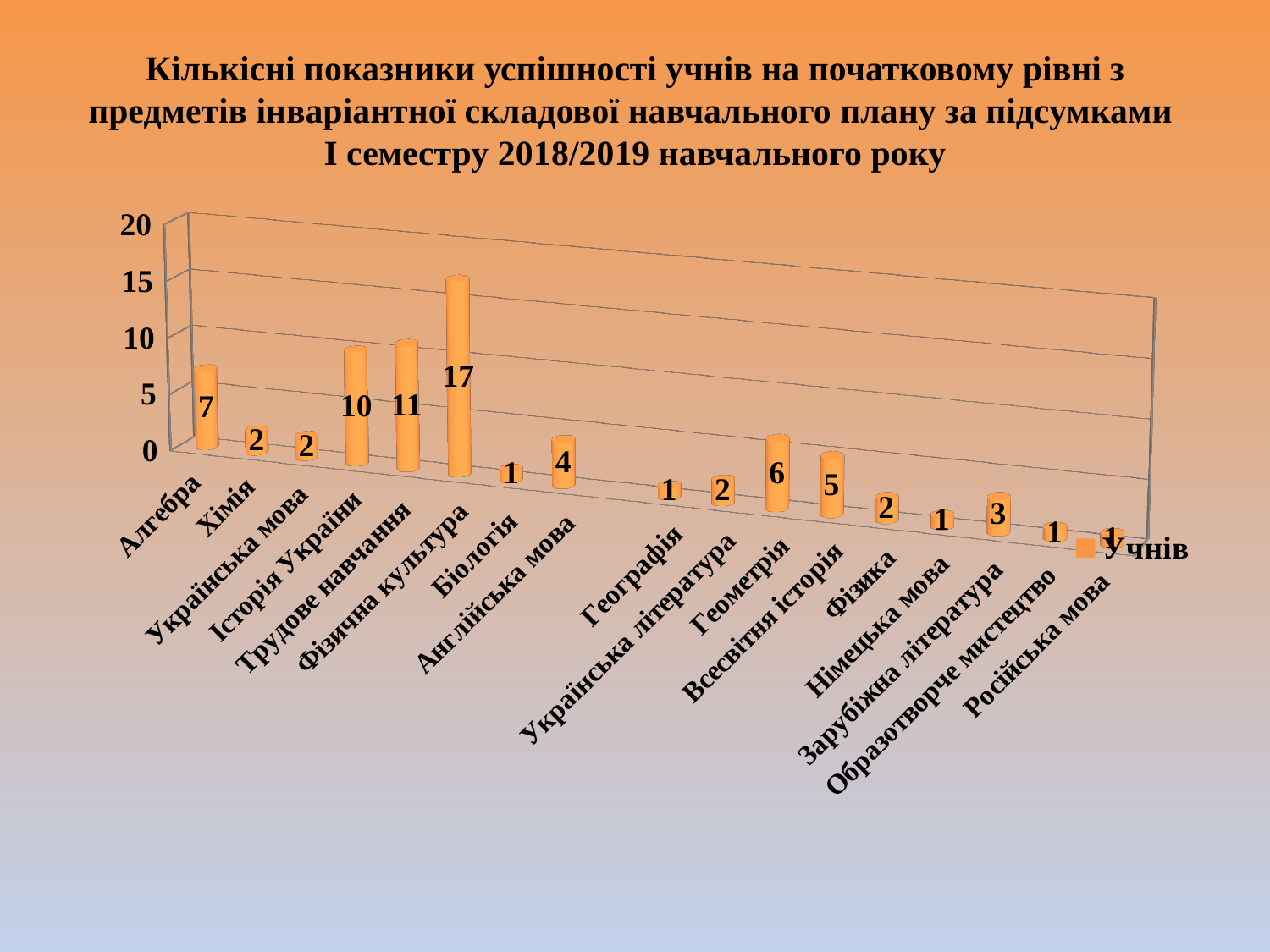
How many subjects (categories) are shown on the x axis? 17 What is the difference between the values for Історія України and Алгебра? 3 Is the value for Фізична культура greater or less than 15? greater What is the value for Фізична культура? 17 What is the value for Зарубіжна література? 3 What is the value for Геометрія? 6 Which subject has the highest value? Фізична культура What series name does the legend show? Учнів What is the difference between the values for Фізична культура and Трудове навчання? 6 What type of chart is shown on the slide? bar chart What is the value for Трудове навчання? 11 Which is larger, the value for Геометрія or the value for Всесвітня історія? Геометрія